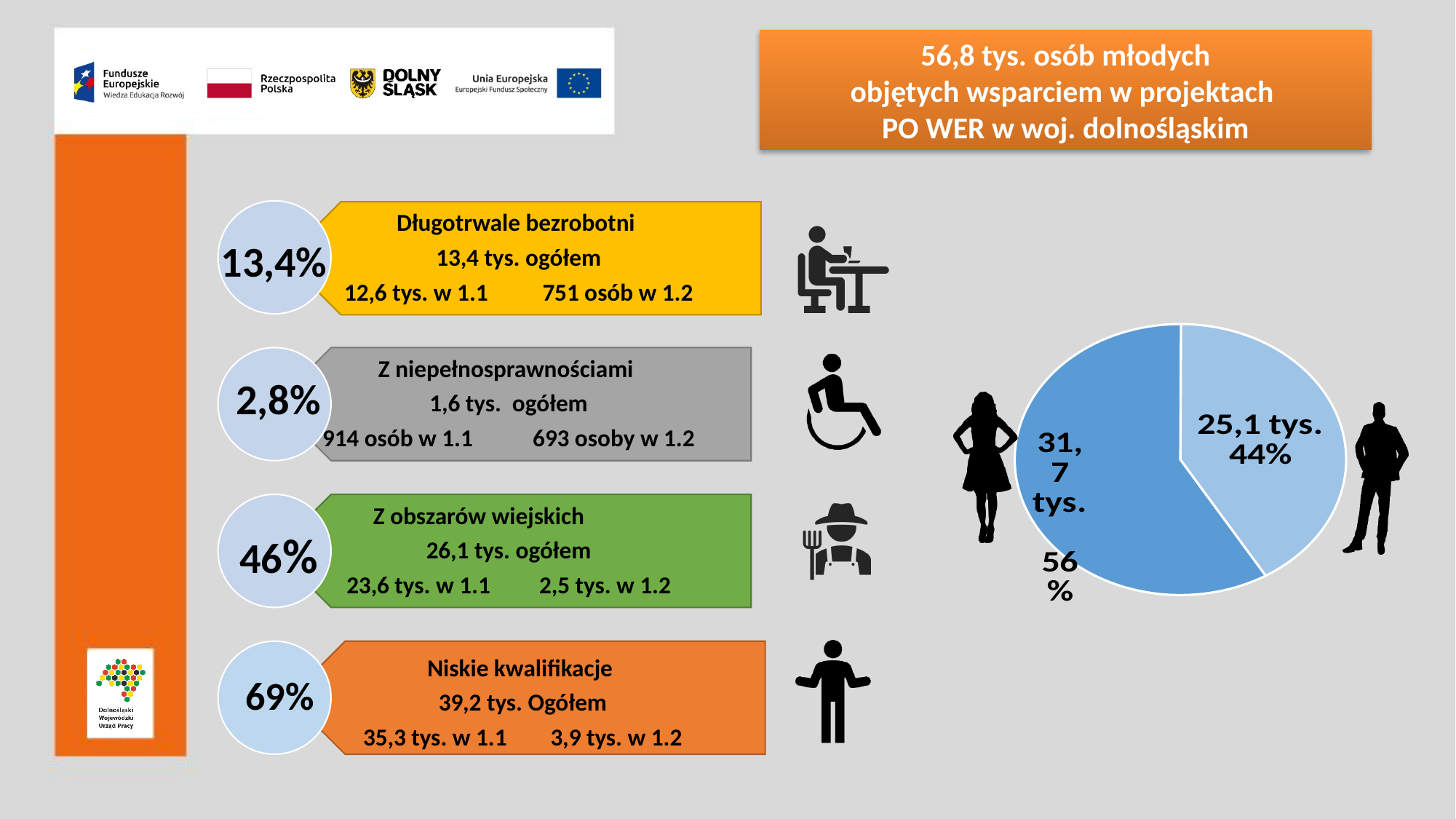
What percentage is shown on the larger (darker blue) slice of the pie chart? 56% What is the difference in percentage points between the two slices of the pie chart (56% and 44%)? 12 percentage points What kind of chart is shown on the right side of the slide? pie chart What value in thousands is printed on the lighter blue slice of the pie chart? 25,1 tys. Is the share of the darker blue slice of the pie chart greater or less than 50%? greater How many slices does the pie chart have? 2 What is the difference in thousands between the two slices of the pie chart (31,7 tys. and 25,1 tys.)? 6,6 tys. What value in thousands is printed on the larger (darker blue) slice of the pie chart? 31,7 tys. Which silhouette stands next to the 56% slice of the pie chart, a woman or a man? a woman What is the total of the two pie chart slices, 31,7 tys. and 25,1 tys.? 56,8 tys. What percentage is shown on the lighter blue slice of the pie chart, next to the male silhouette? 44% Which slice of the pie chart is larger: the one labelled 31,7 tys. or the one labelled 25,1 tys.? 31,7 tys.